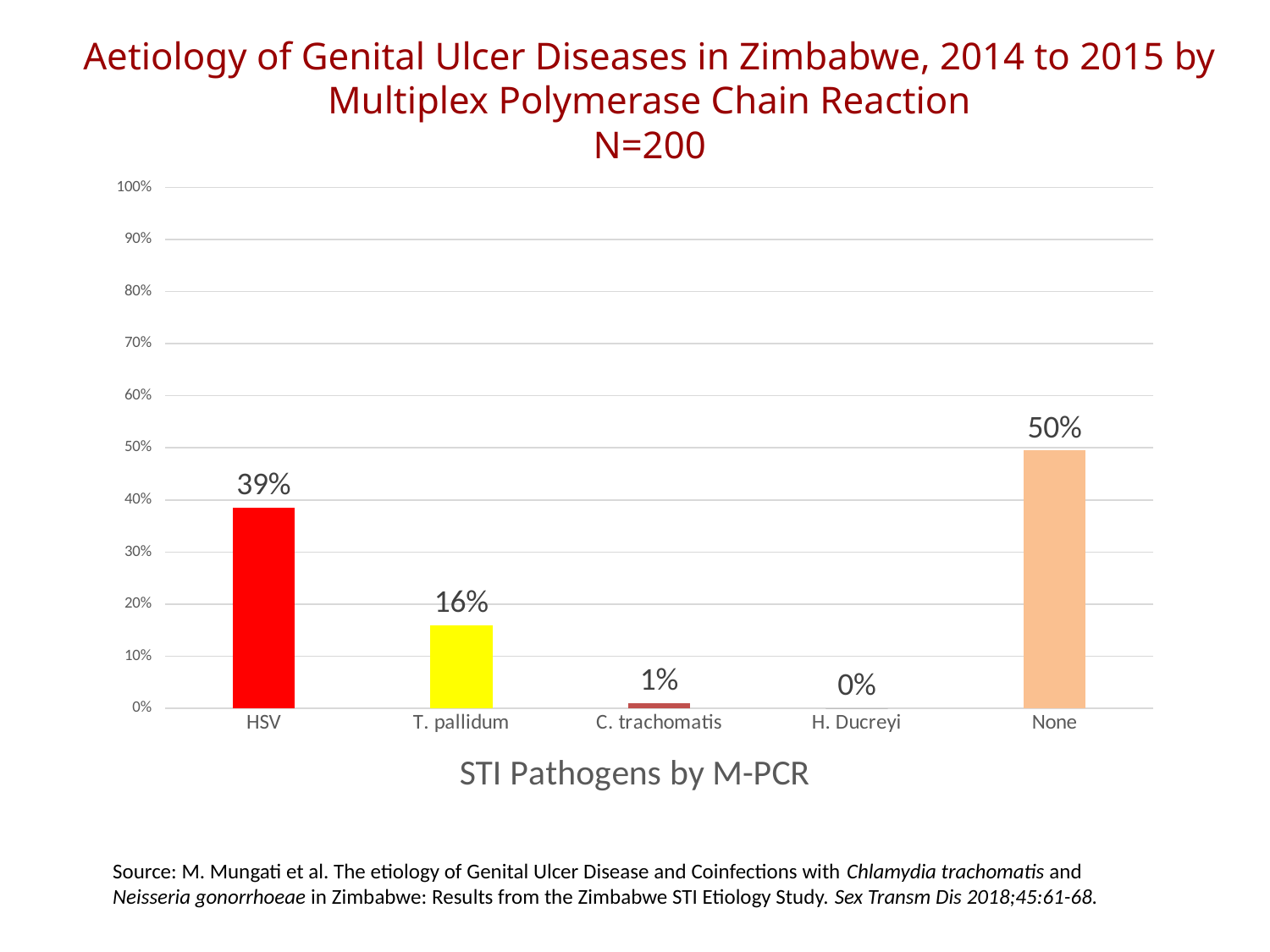
What percentage is shown for T. pallidum? 16% What percentage is shown for C. trachomatis? 1% Which category has the highest value? None What percentage is shown for None? 50% Which category has the lowest value? H. Ducreyi How many categories are shown on the x axis? 5 What percentage is shown for HSV? 39% What is the difference between the values for None and HSV? 11% Which is larger, the value for HSV or the value for T. pallidum? HSV What percentage is shown for H. Ducreyi? 0% What is the x-axis title of the chart? STI Pathogens by M-PCR What kind of chart is shown on the slide? Bar chart